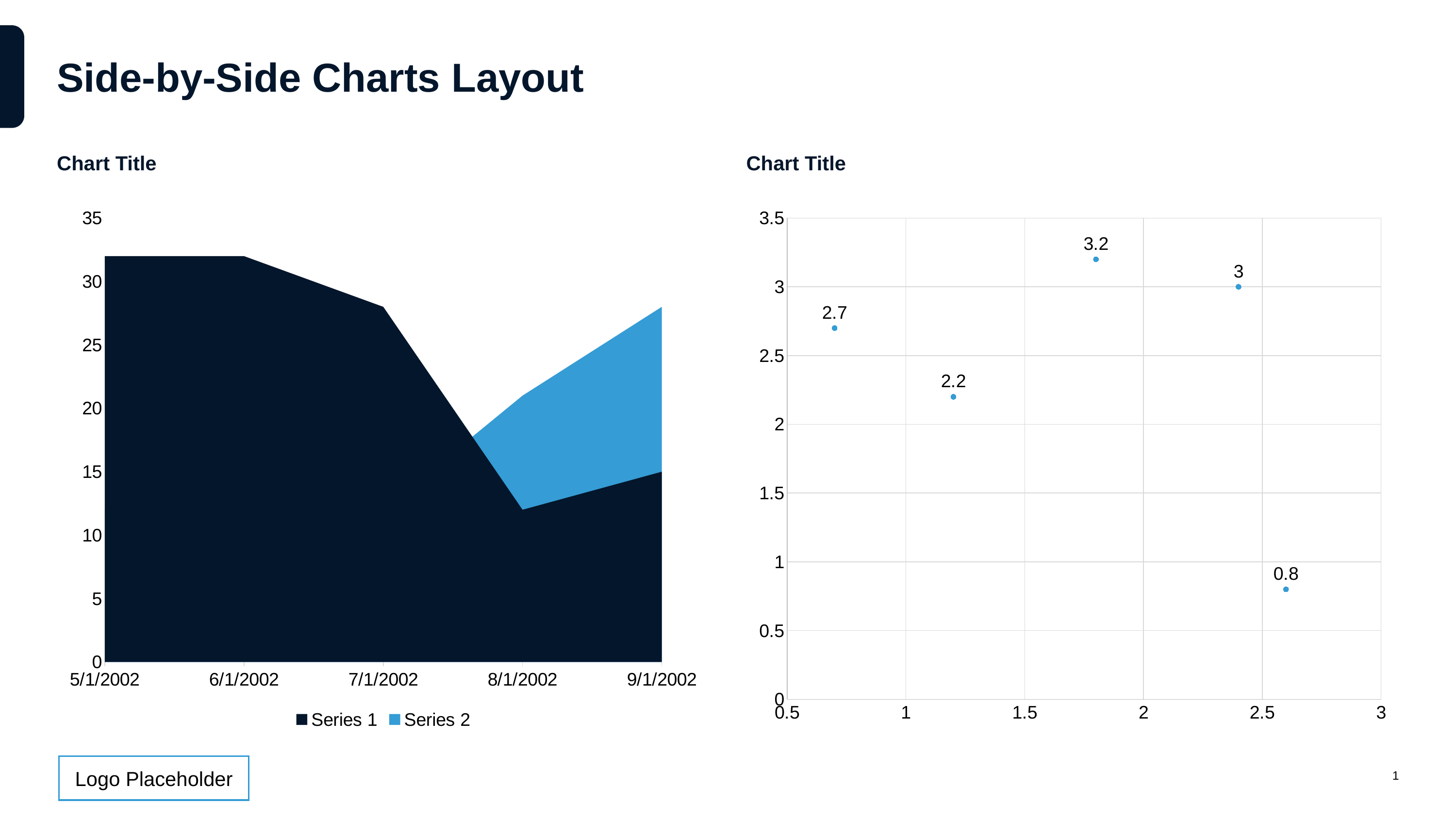
In the left chart, does Series 1 rise or fall from 5/1/2002 to 8/1/2002? fall In the left chart, is the value for Series 1 at 5/1/2002 greater or less than 30? greater In the right chart, what is the lowest labelled value? 0.8 What kind of chart is the chart on the left side of the slide? area chart In the right chart, what is the difference between the highest labelled value (3.2) and the lowest labelled value (0.8)? 2.4 What are the two legend entries of the left chart? Series 1, Series 2 What kind of chart is the chart on the right side of the slide? scatter chart How many data points are plotted in the right chart? 5 How many series does the legend of the left chart list? 2 In the left chart, is the value for Series 1 at 8/1/2002 greater or less than 15? less In the right chart, what is the highest labelled value? 3.2 How many dates are shown on the x axis of the left chart? 5